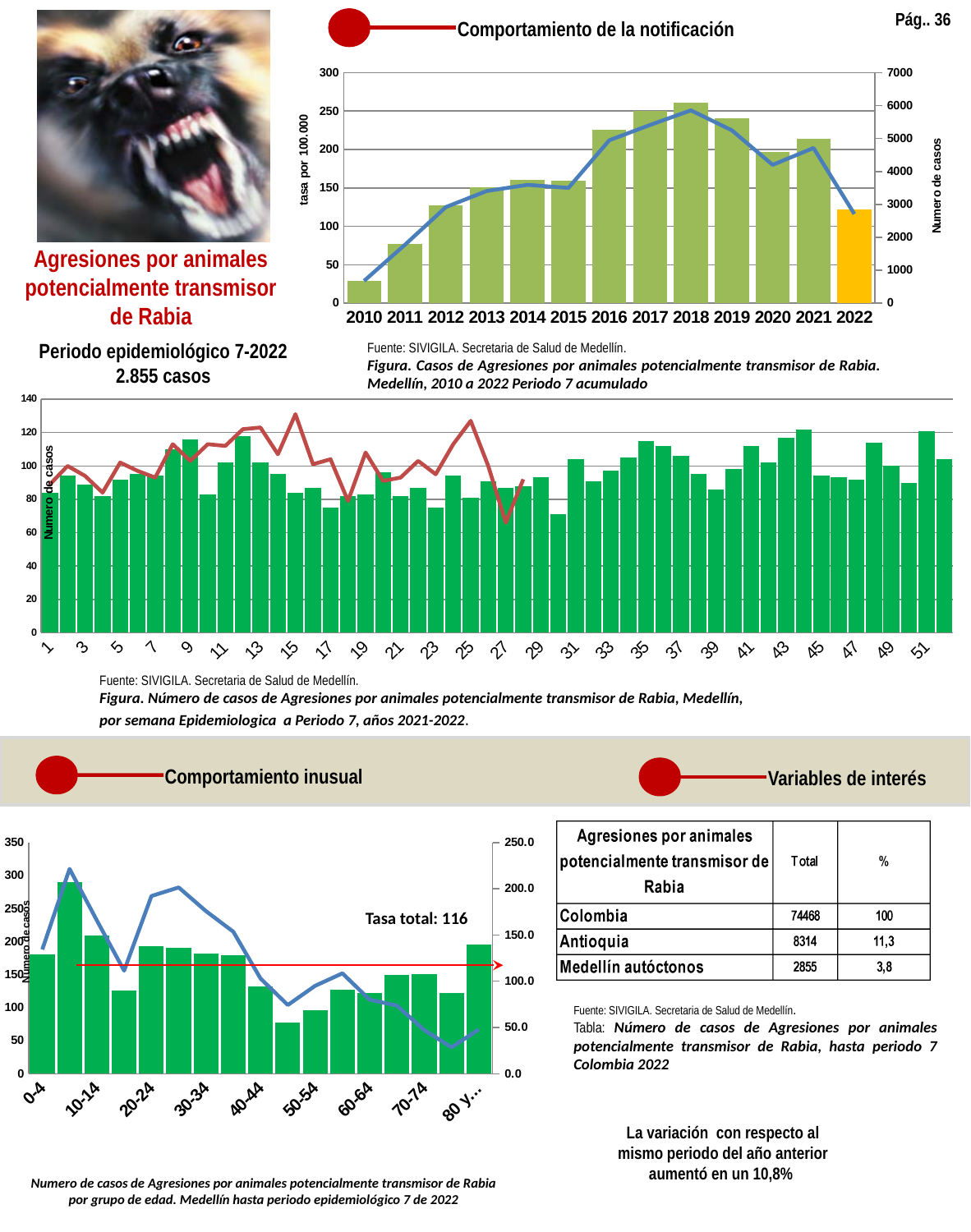
In the top chart (2010 to 2022), which bar is coloured differently (orange) from the others? 2022 In the bottom-left chart of cases by age group, what 'Tasa total' value is printed on the chart? 116 In the top chart (2010 to 2022), which year has the shortest bar? 2010 In the top chart (2010 to 2022), is the bar for 2010 greater or less than 1000 on the right-hand 'Numero de casos' axis? less What kind of chart is the middle chart showing cases by epidemiological week? Bar chart with a line In the top chart (2010 to 2022), is the bar for 2018 greater or less than 5000 on the right-hand 'Numero de casos' axis? greater In the top chart 'Casos de Agresiones por animales potencialmente transmisor de Rabia. Medellín, 2010 a 2022', which year has the tallest bar? 2018 In the top chart (2010 to 2022), how many years are shown on the x axis? 13 In the top chart (2010 to 2022), is the bar for 2021 larger or smaller than the bar for 2022? larger In the bottom-left chart of cases by age group, which labelled age group has the lowest bar? 50-54